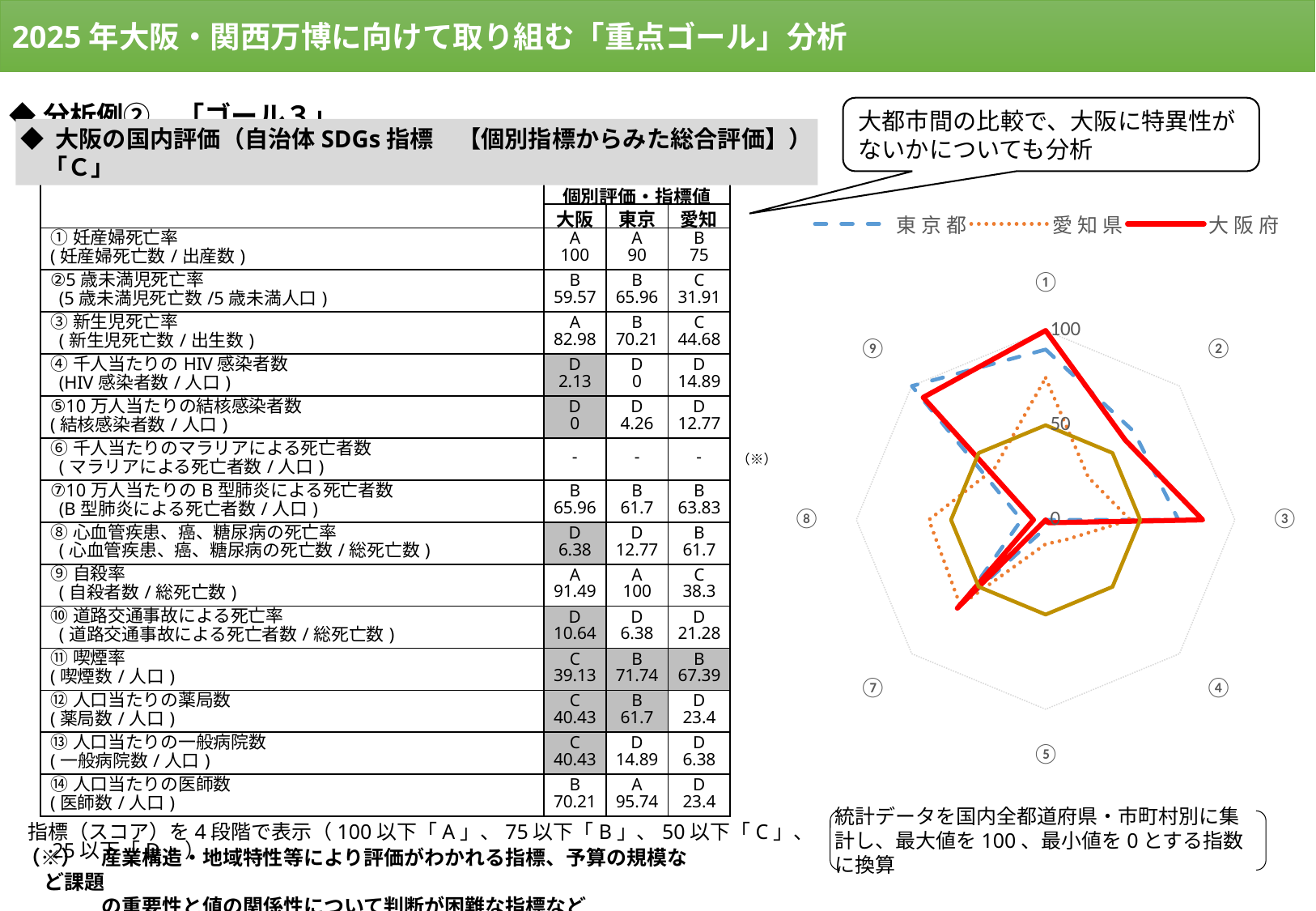
In the radar chart, is the value for 愛知県 on axis ② greater or less than 50? less Which series in the radar chart is drawn as a dashed blue line? 東京都 In the radar chart, which series has the highest value on axis ①? 大阪府 In the radar chart, which series has the lowest value on axis ③? 愛知県 In the radar chart, what is the value for 大阪府 on axis ①? 100 What is the maximum value shown on the radar chart's scale? 100 What kind of chart is shown on the right side of the slide? Radar chart In the radar chart, is the value for 愛知県 on axis ① greater or less than 50? greater In the radar chart, which is larger on axis ③: the value for 大阪府 or the value for 愛知県? 大阪府 How many series does the legend of the radar chart list? 3 Which series in the radar chart is drawn as a solid red line? 大阪府 In the radar chart, is the value for 大阪府 on axis ③ greater or less than 50? greater